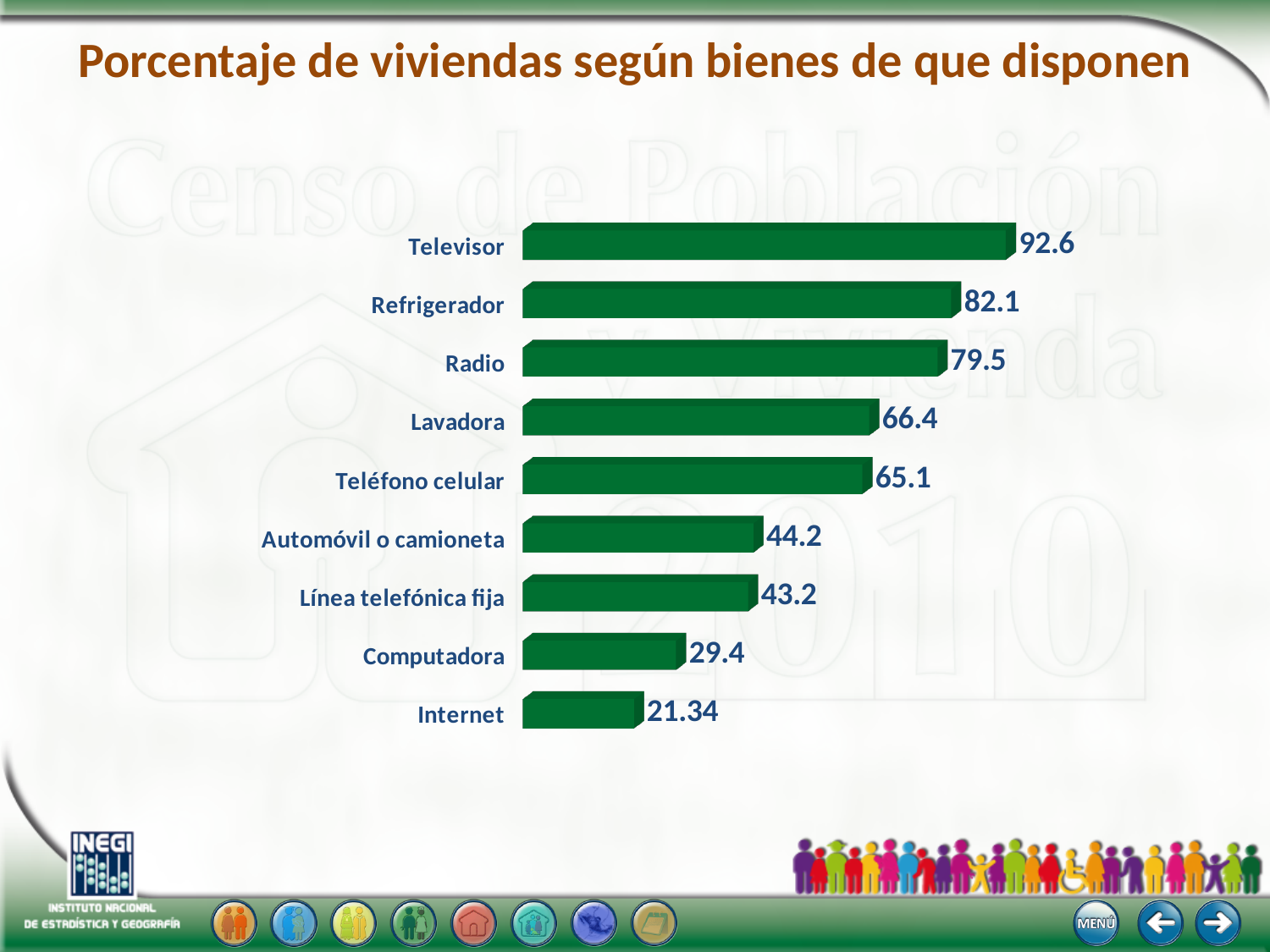
What is the difference between the values for Televisor and Computadora? 63.2 What is the difference between the values for Refrigerador and Radio? 2.6 What is the value for Televisor? 92.6 Which is larger, the value for Lavadora or the value for Automóvil o camioneta? Lavadora What is the title of the slide? Porcentaje de viviendas según bienes de que disponen What is the value for Teléfono celular? 65.1 Which category has the lowest value? Internet Which is larger, the value for Computadora or the value for Línea telefónica fija? Línea telefónica fija What kind of chart is shown on the slide? Bar chart Which category has the highest value? Televisor How many categories are shown in the chart? 9 What is the value for Internet? 21.34